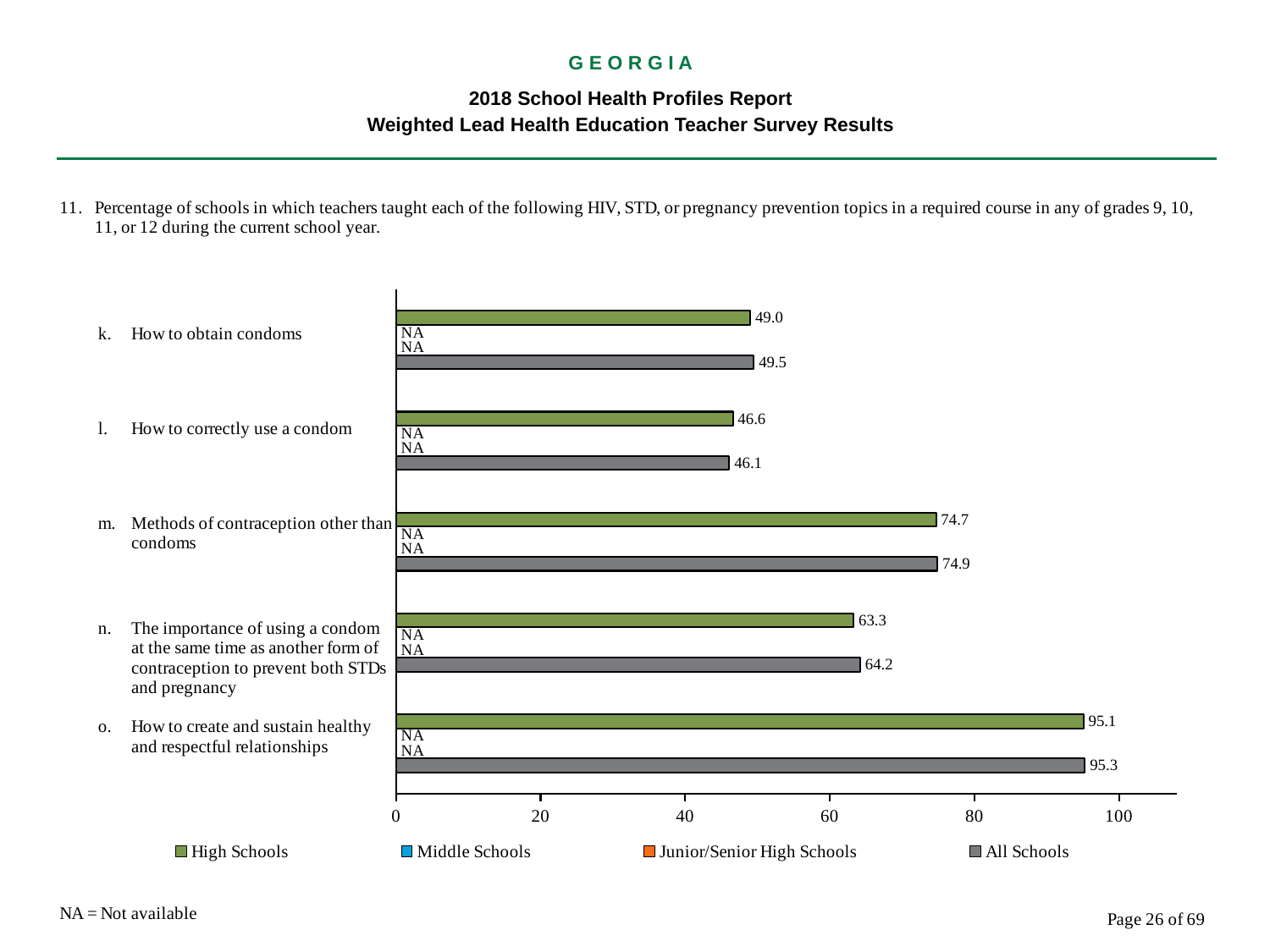
How many series does the legend list? 4 Which is larger for "How to obtain condoms": the High Schools value or the All Schools value? All Schools What kind of chart is shown on the slide? Bar chart How many topics are listed on the chart? 5 What is the difference between the All Schools and High Schools values for "The importance of using a condom at the same time as another form of contraception to prevent both STDs and pregnancy"? 0.9 What is the High Schools value for "How to obtain condoms"? 49.0 Which topic has the lowest All Schools value? How to correctly use a condom Is the High Schools value for "Methods of contraception other than condoms" greater or less than 60? greater What is the High Schools value for "Methods of contraception other than condoms"? 74.7 What is the All Schools value for "How to correctly use a condom"? 46.1 Which topic has the highest High Schools value? How to create and sustain healthy and respectful relationships What is the All Schools value for "How to create and sustain healthy and respectful relationships"? 95.3